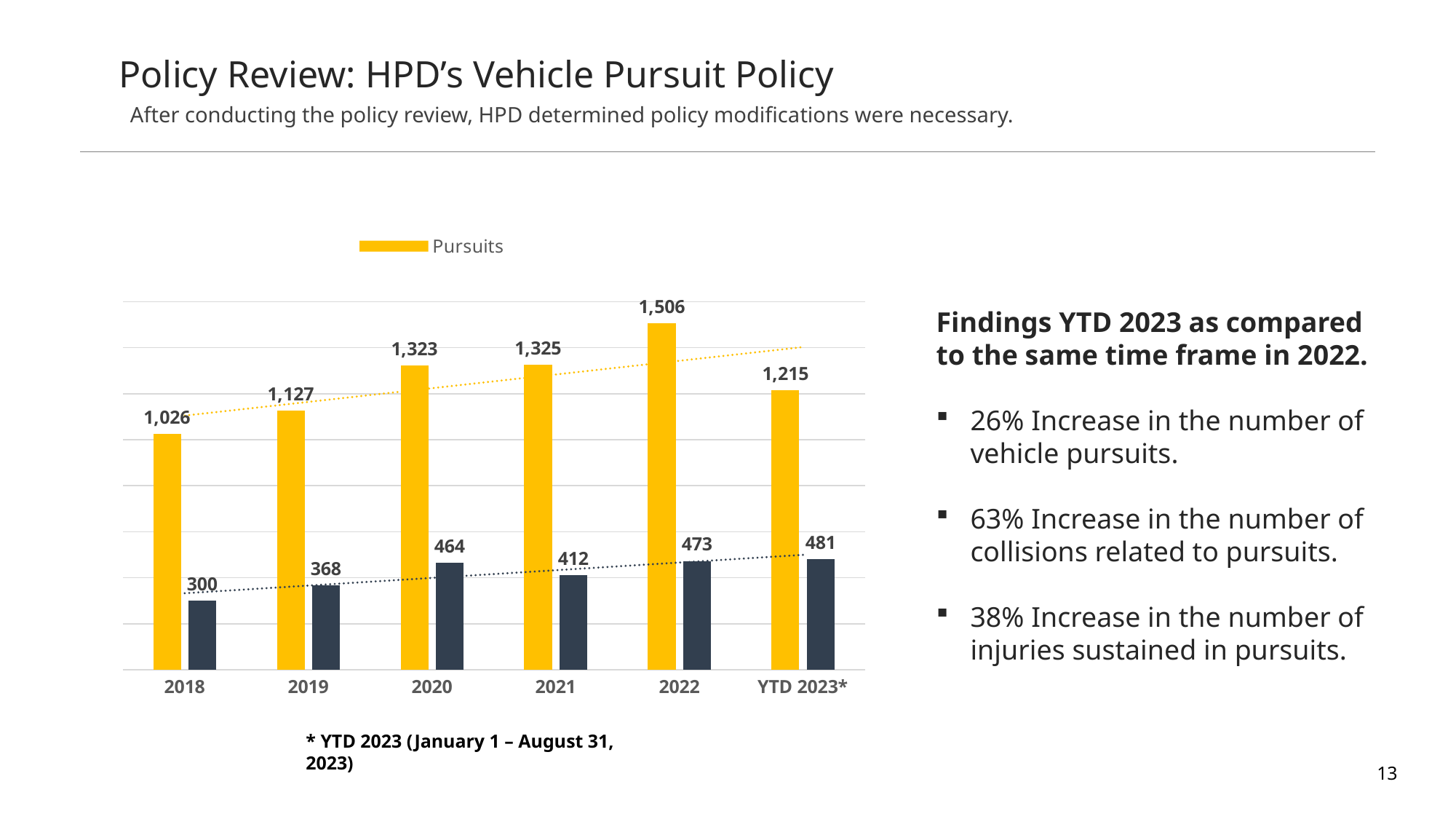
What kind of chart is shown on the slide? Bar chart What is the value of the dark blue bar for 2020? 464 How many categories are shown on the x axis? 6 What is the value of the dark blue bar for YTD 2023*? 481 What is the difference between the dark blue bar values for 2020 and 2021? 52 What is the number of pursuits in 2018? 1,026 Which year has the highest number of pursuits? 2022 What is the only entry listed in the chart legend? Pursuits What is the difference in pursuits between 2022 and YTD 2023*? 291 What is the number of pursuits in 2022? 1,506 Which year has the lowest value for the dark blue bars? 2018 Which is larger, the number of pursuits in 2019 or in 2021? 2021